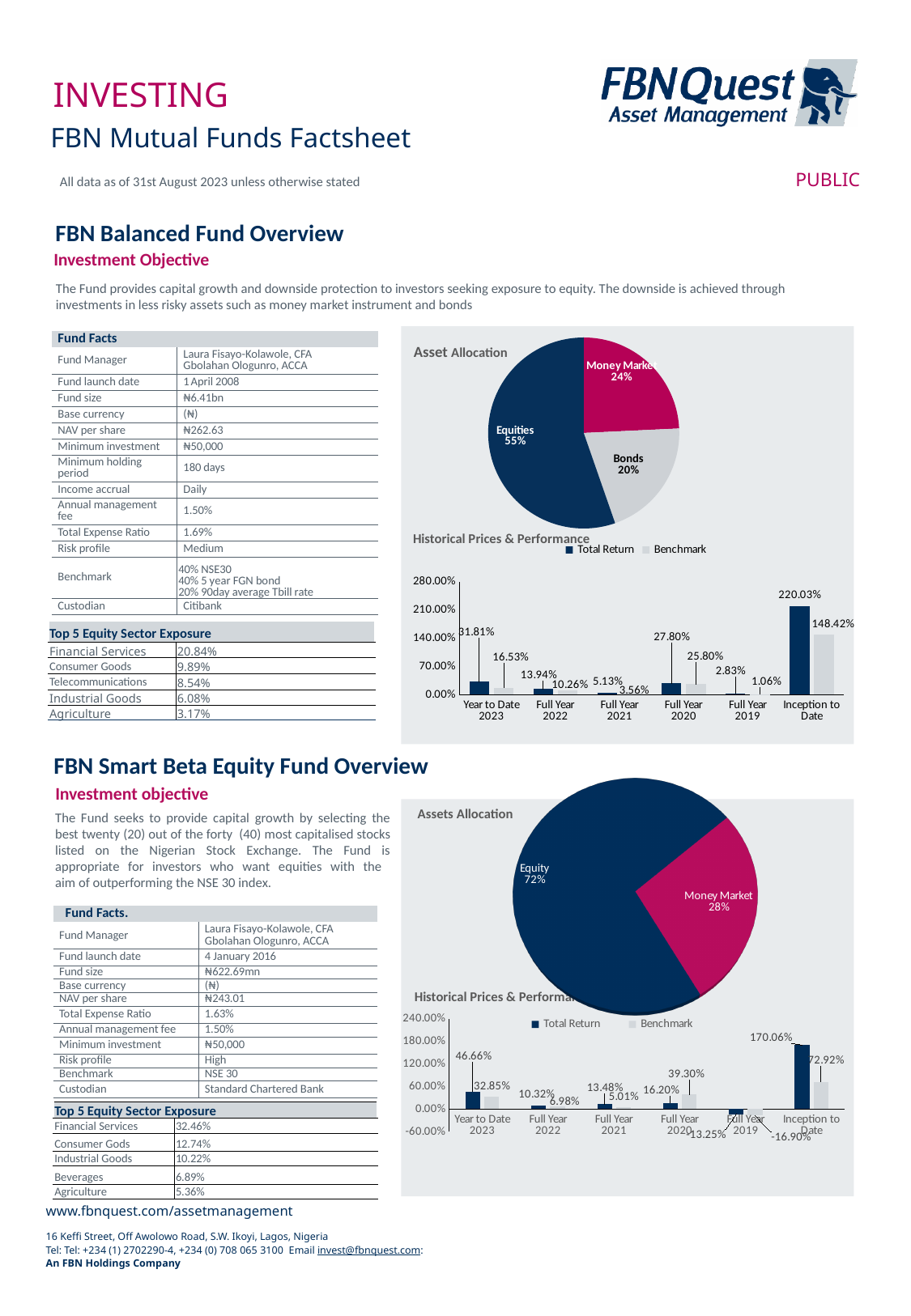
In the FBN Smart Beta Equity Fund Historical Prices & Performance chart, which is larger for Full Year 2019, Total Return or Benchmark? Total Return In the FBN Balanced Fund Asset Allocation pie chart, what share is allocated to Equities? 55% In the FBN Balanced Fund Historical Prices & Performance chart, which period has the lowest Total Return? Full Year 2019 How many series does the legend of the FBN Balanced Fund Historical Prices & Performance chart list? 2 In the FBN Smart Beta Equity Fund Assets Allocation pie chart, what share is allocated to Money Market? 28% How many slices does the FBN Balanced Fund Asset Allocation pie chart have? 3 In the FBN Smart Beta Equity Fund Historical Prices & Performance chart, what is the Benchmark value for Full Year 2020? 39.30% In the FBN Balanced Fund Historical Prices & Performance chart, what is the Benchmark value for Year to Date 2023? 16.53% In the FBN Balanced Fund Asset Allocation pie chart, which asset class has the smallest share? Bonds In the FBN Balanced Fund Historical Prices & Performance chart, what is the difference between Total Return and Benchmark for Full Year 2020? 2.00% In the FBN Balanced Fund Historical Prices & Performance chart, what is the Total Return for Inception to Date? 220.03% What type of chart is the FBN Smart Beta Equity Fund Historical Prices & Performance chart? Bar chart